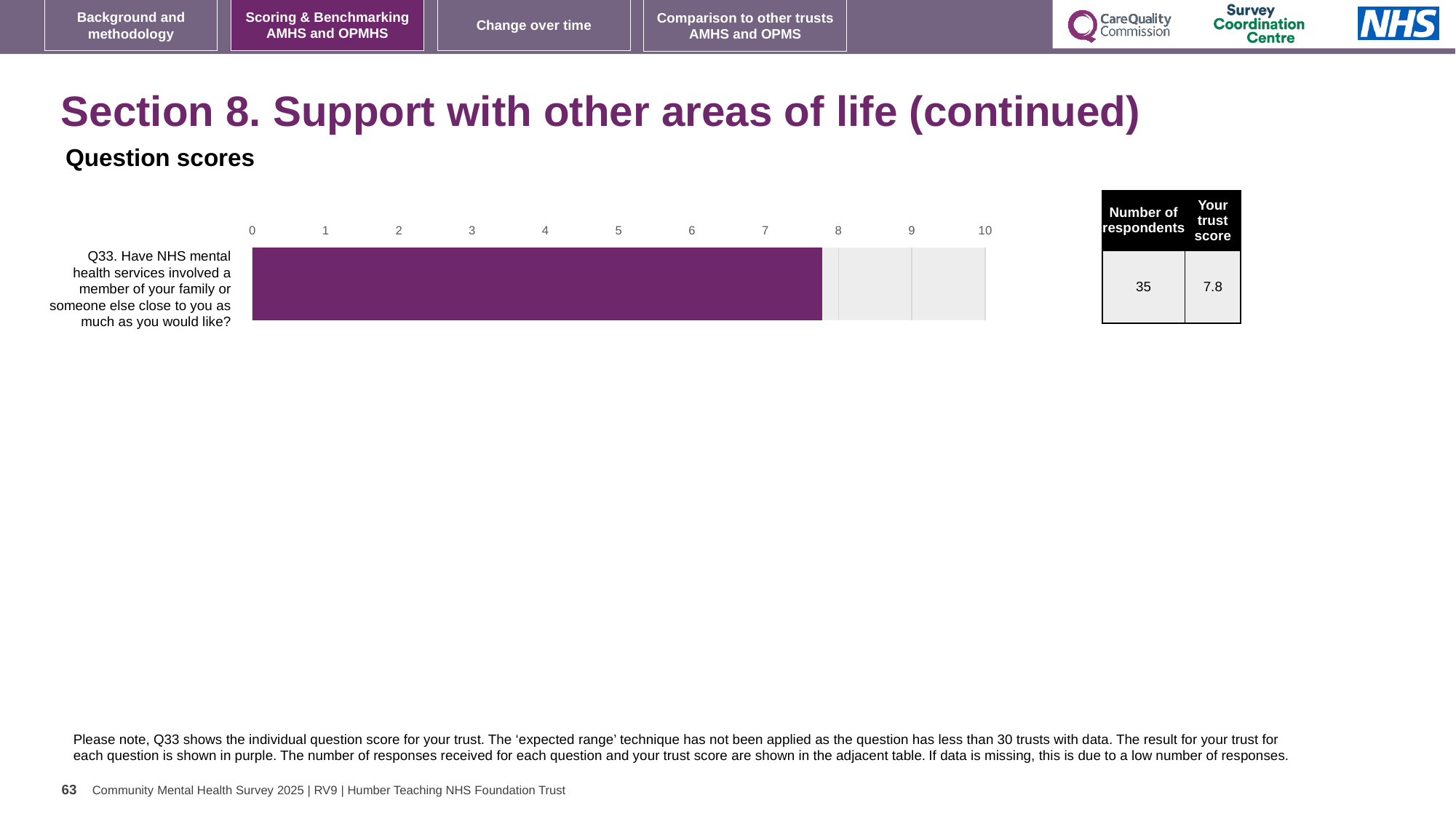
How many questions (bars) are plotted in the chart? 1 What kind of chart is shown on the slide? bar chart What is the trust score for Q33 shown in the adjacent table? 7.8 What colour is the bar for Q33? purple How many respondents answered Q33 according to the table? 35 Is the value of the bar for Q33 greater or less than 8? less Is the value of the bar for Q33 greater or less than 5? greater What is the highest value shown on the chart's horizontal axis? 10